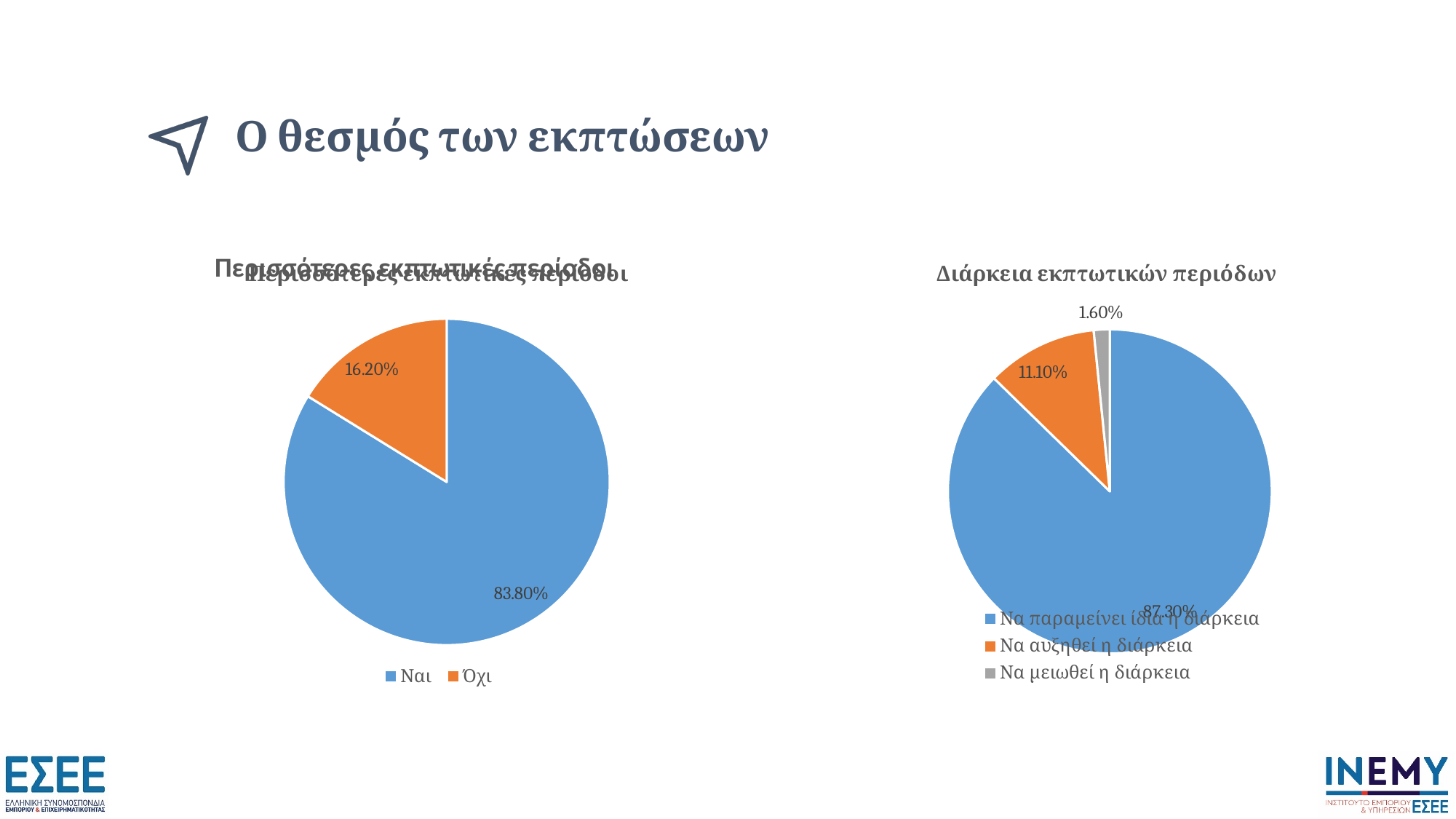
In the right chart (Διάρκεια εκπτωτικών περιόδων), what percentage is shown for Να παραμείνει ίδια η διάρκεια? 87.30% In the left chart (Περισσότερες εκπτωτικές περίοδοι), what is the difference between the Ναι and Όχι shares? 67.60% In the right chart (Διάρκεια εκπτωτικών περιόδων), what percentage is shown for Να αυξηθεί η διάρκεια? 11.10% In the right chart (Διάρκεια εκπτωτικών περιόδων), which colour represents Να μειωθεί η διάρκεια? Grey How many categories does the legend of the left chart (Περισσότερες εκπτωτικές περίοδοι) list? 2 In the right chart (Διάρκεια εκπτωτικών περιόδων), what percentage is shown for Να μειωθεί η διάρκεια? 1.60% In the left chart (Περισσότερες εκπτωτικές περίοδοι), which category has the largest share? Ναι What type of chart is the left chart (Περισσότερες εκπτωτικές περίοδοι)? Pie chart In the right chart (Διάρκεια εκπτωτικών περιόδων), which category has the smallest share? Να μειωθεί η διάρκεια In the left chart (Περισσότερες εκπτωτικές περίοδοι), what percentage is shown for Ναι? 83.80% In the right chart (Διάρκεια εκπτωτικών περιόδων), how many slices does the pie have? 3 In the left chart (Περισσότερες εκπτωτικές περίοδοι), what percentage is shown for Όχι? 16.20%